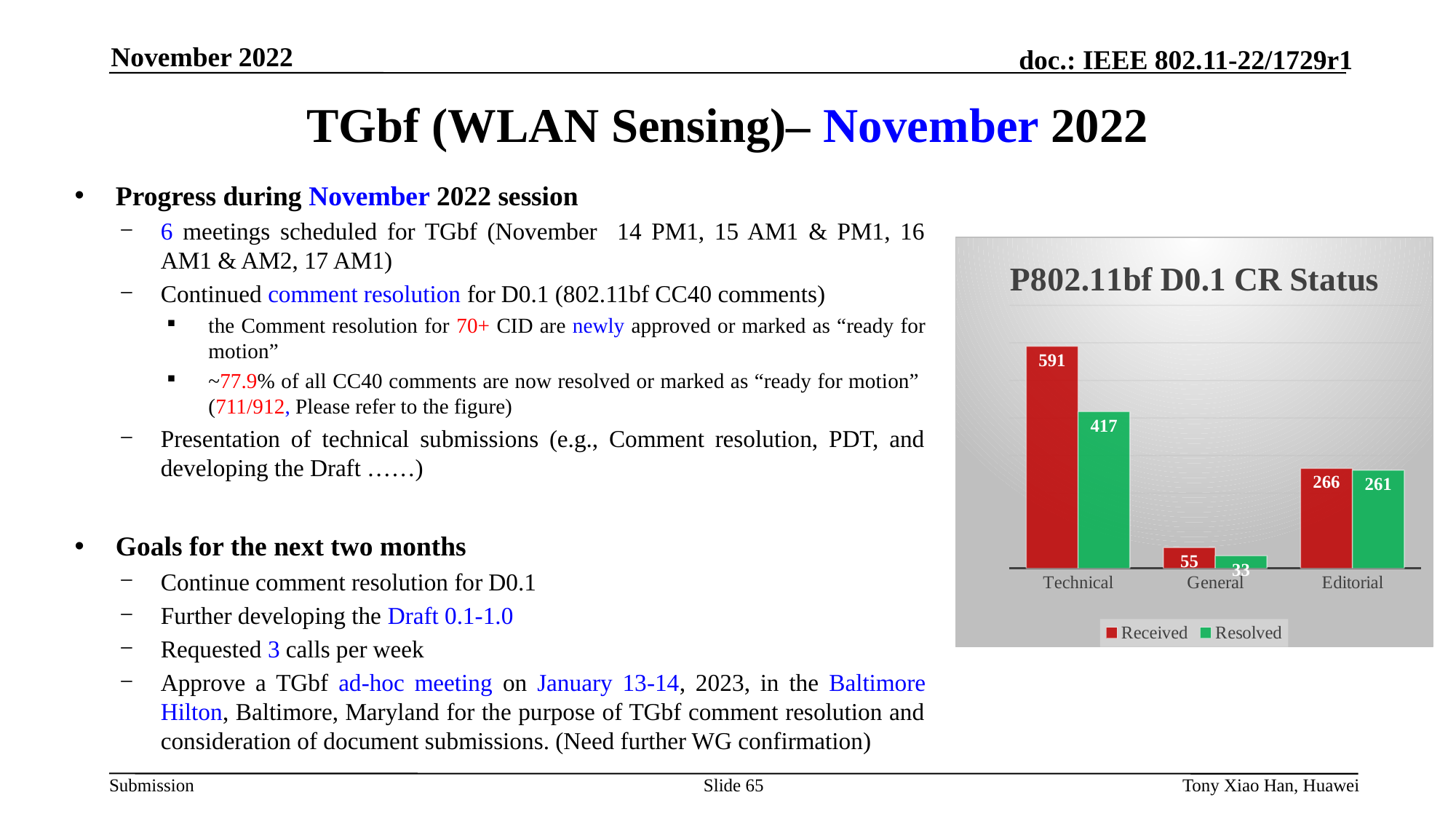
How many categories are shown on the x axis? 3 Which category has the highest Received value? Technical What is the Received value for Editorial? 266 What is the Resolved value for Editorial? 261 What is the title of the chart? P802.11bf D0.1 CR Status What is the difference between Received and Resolved for Technical? 174 How many series does the legend list? 2 What is the Received value for General? 55 Which category has the lowest Resolved value? General What is the Received value for Technical? 591 What is the Resolved value for General? 33 What is the Resolved value for Technical? 417